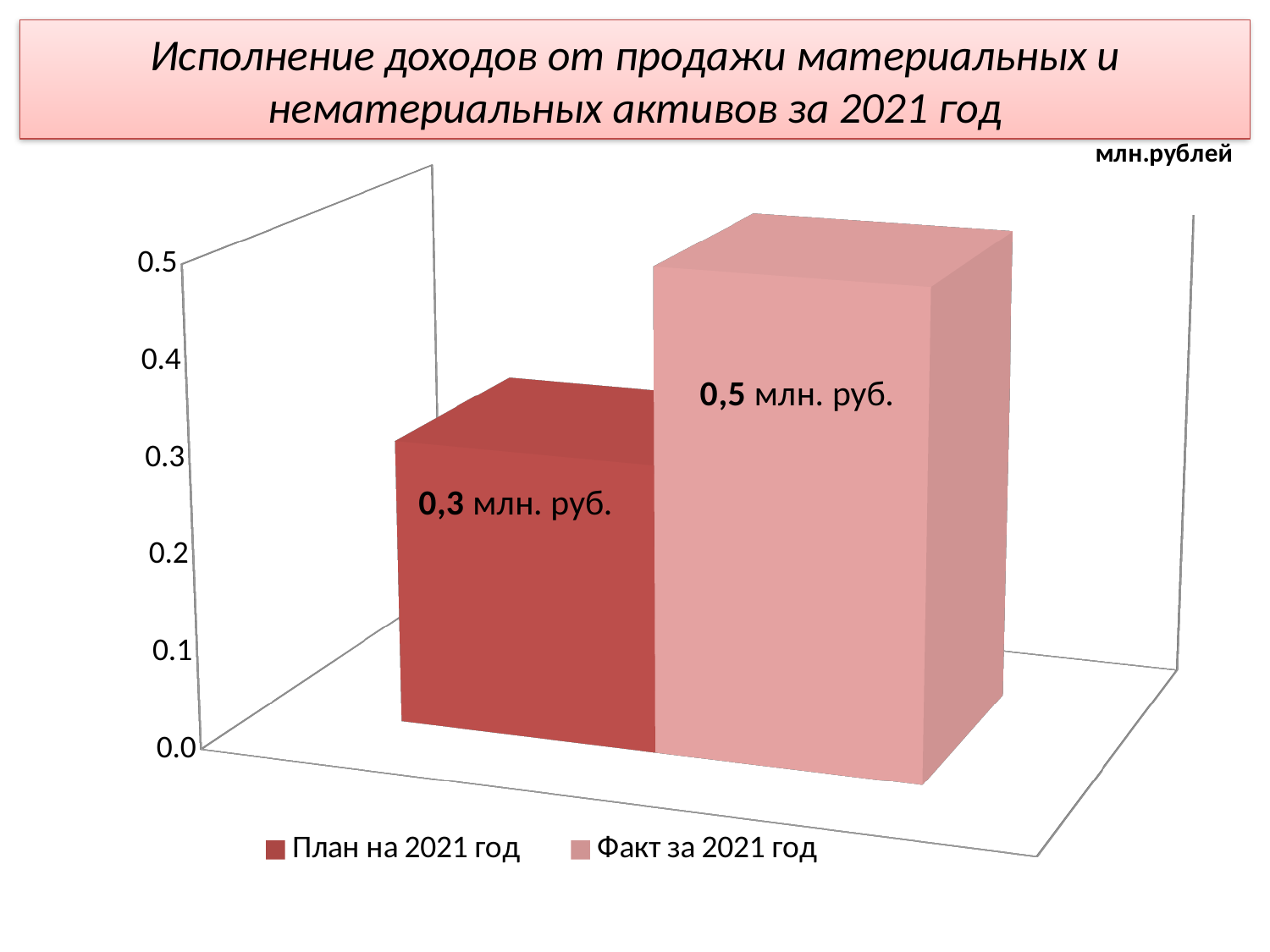
What kind of chart is shown on the slide? bar chart Which legend entry is shown in the darker red colour? План на 2021 год What is the value for «План на 2021 год»? 0,3 млн. руб. How many series does the legend list? 2 What unit of measurement is indicated above the chart? млн.рублей What is the value for «Факт за 2021 год»? 0,5 млн. руб. Is the value for «План на 2021 год» larger or smaller than the value for «Факт за 2021 год»? smaller Is the value for «План на 2021 год» greater or less than 0.4? less Which series has the lower value? План на 2021 год How many bars are plotted on the chart? 2 Which series has the higher value, «План на 2021 год» or «Факт за 2021 год»? Факт за 2021 год What is the difference between «Факт за 2021 год» and «План на 2021 год»? 0,2 млн. руб.